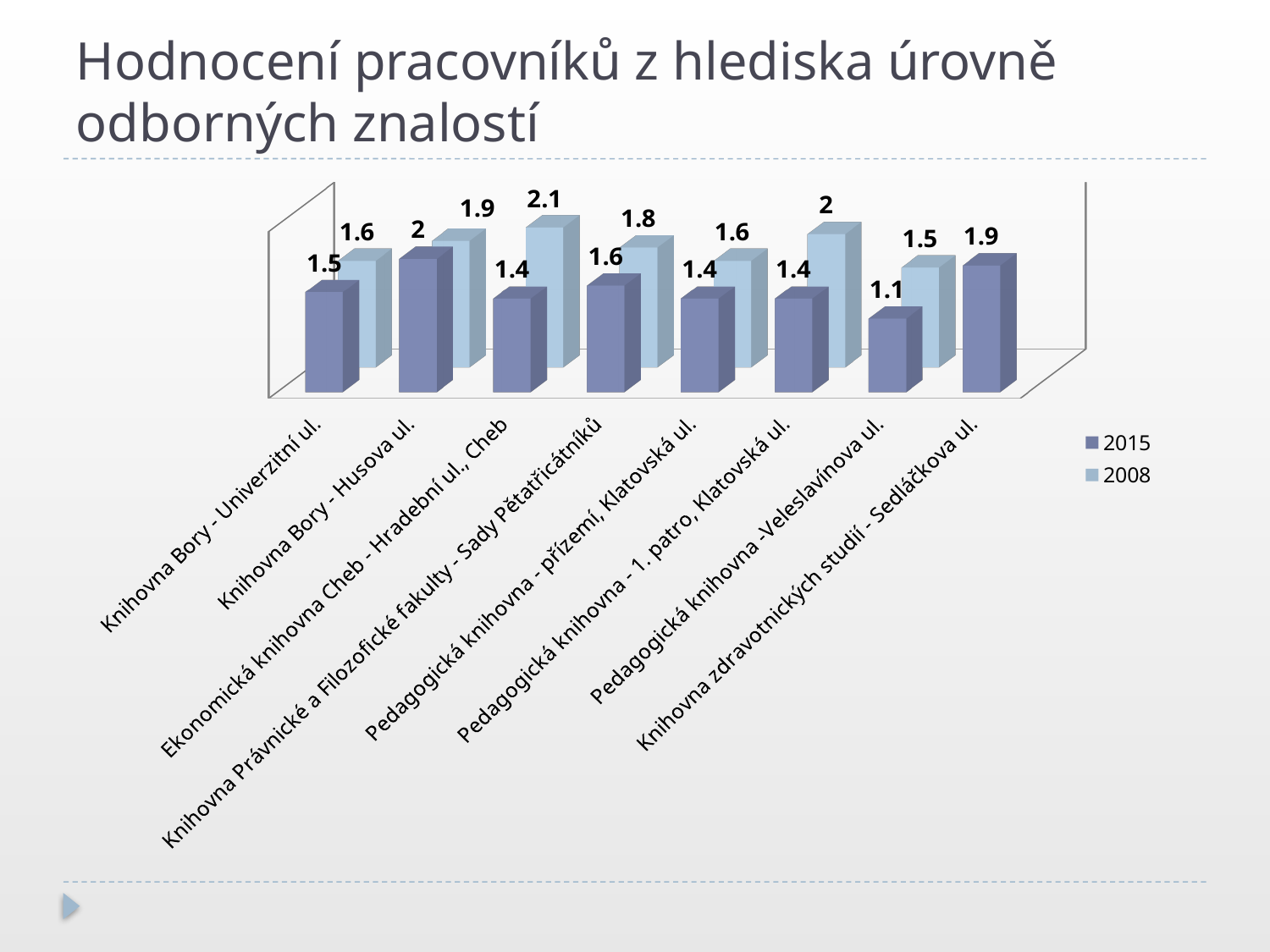
How many series does the legend list? 2 What is the 2015 value for Pedagogická knihovna - Veleslavínova ul.? 1.1 Which series is shown in the darker blue colour? 2015 What is the difference between the 2008 and 2015 values for Pedagogická knihovna - 1. patro, Klatovská ul.? 0.6 What is the 2015 value for Knihovna Bory - Univerzitní ul.? 1.5 What kind of chart is shown on the slide? Bar chart Which category has the highest 2008 value? Ekonomická knihovna Cheb - Hradební ul., Cheb What is the 2008 value for Knihovna Právnické a Filozofické fakulty - Sady Pětatřicátníků? 1.8 Which category has the lowest 2015 value? Pedagogická knihovna - Veleslavínova ul. For Knihovna Bory - Husova ul., which is larger: the 2015 value or the 2008 value? 2015 What is the 2008 value for Ekonomická knihovna Cheb - Hradební ul., Cheb? 2.1 How many categories are shown on the x axis? 8